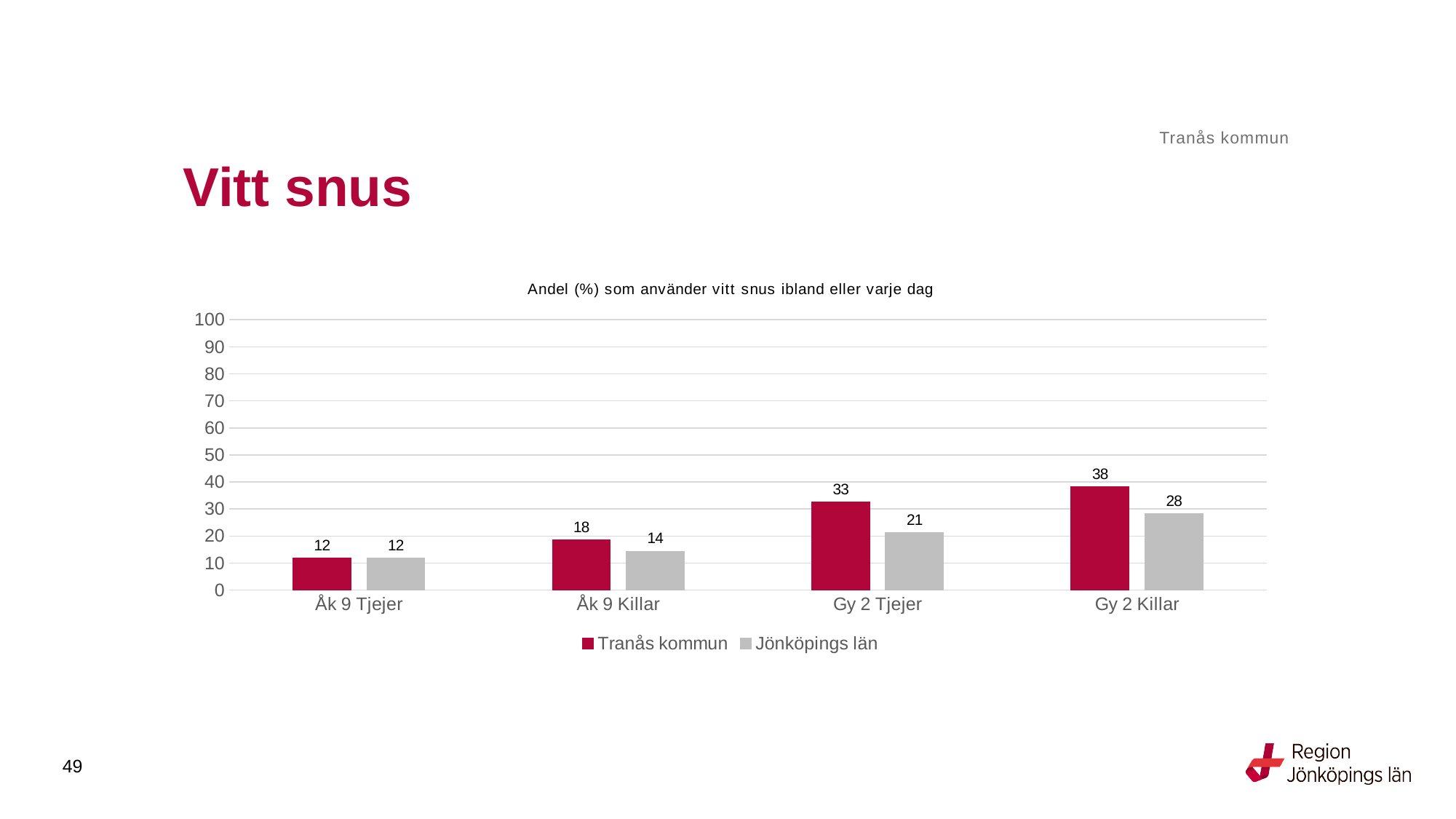
Which is larger for Gy 2 Killar: Tranås kommun or Jönköpings län? Tranås kommun How many categories are shown on the x axis? 4 What is the value for Jönköpings län for Åk 9 Killar? 14 What is the difference between Tranås kommun and Jönköpings län for Gy 2 Tjejer? 12 Is the value for Tranås kommun for Gy 2 Killar greater or less than 30? greater What is the value for Tranås kommun for Gy 2 Killar? 38 Which category has the lowest value for Jönköpings län? Åk 9 Tjejer What is the title of the chart? Andel (%) som använder vitt snus ibland eller varje dag What is the value for Tranås kommun for Gy 2 Tjejer? 33 What kind of chart is shown on the slide? Bar chart Which category has the highest value for Tranås kommun? Gy 2 Killar How many series does the legend list? 2